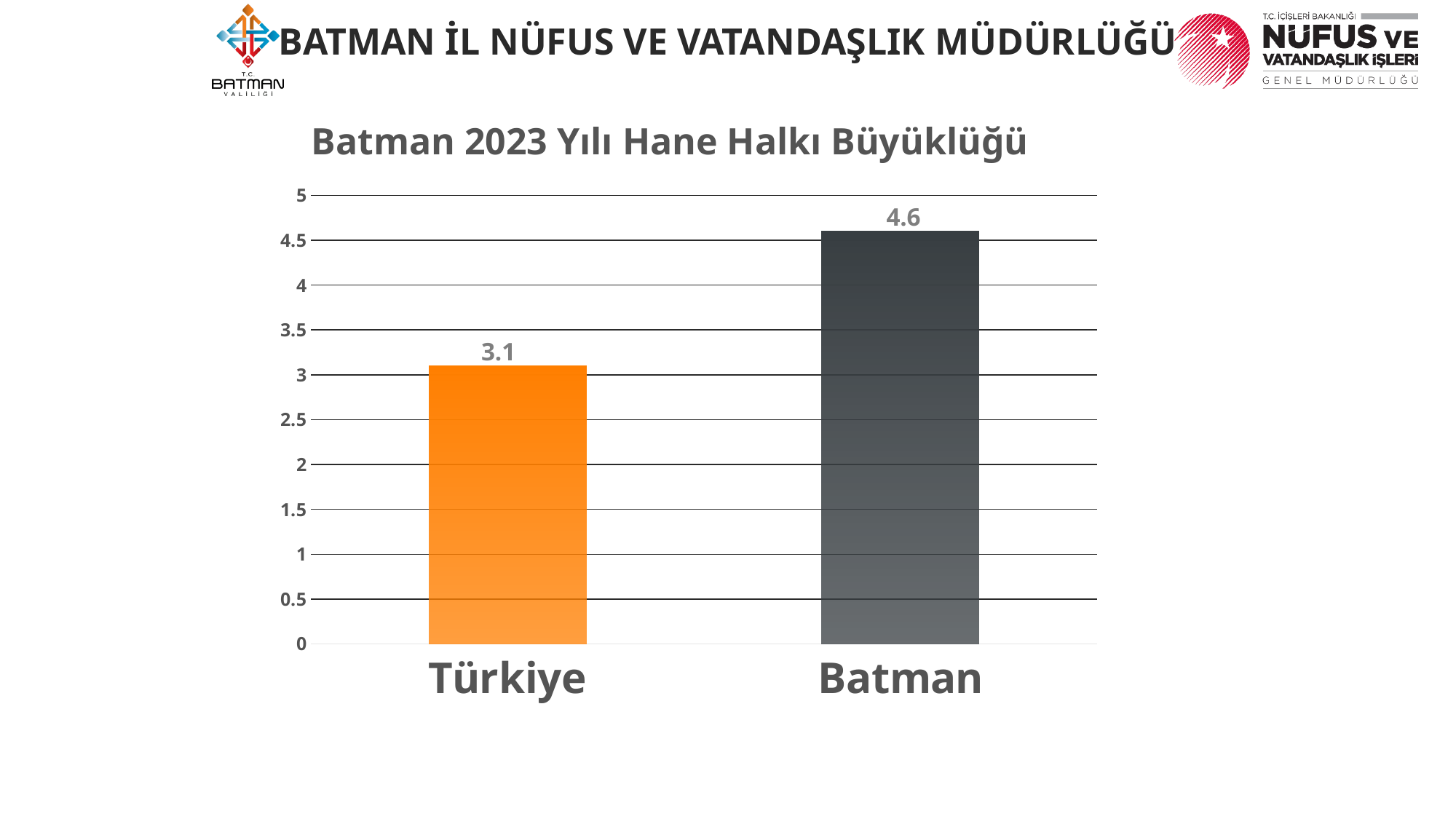
Which is larger, the value for Türkiye or the value for Batman? Batman What kind of chart is shown on the slide? bar chart What is the title of the chart? Batman 2023 Yılı Hane Halkı Büyüklüğü What is the value for Batman? 4.6 What is the value for Türkiye? 3.1 What is the difference between the values for Batman and Türkiye? 1.5 Which category has the lowest value? Türkiye How many categories are shown in the chart? 2 Is the value for Batman greater or less than 4? greater What colour is the bar for Türkiye? orange Is the value for Türkiye greater or less than 3.5? less Which category has the highest value? Batman